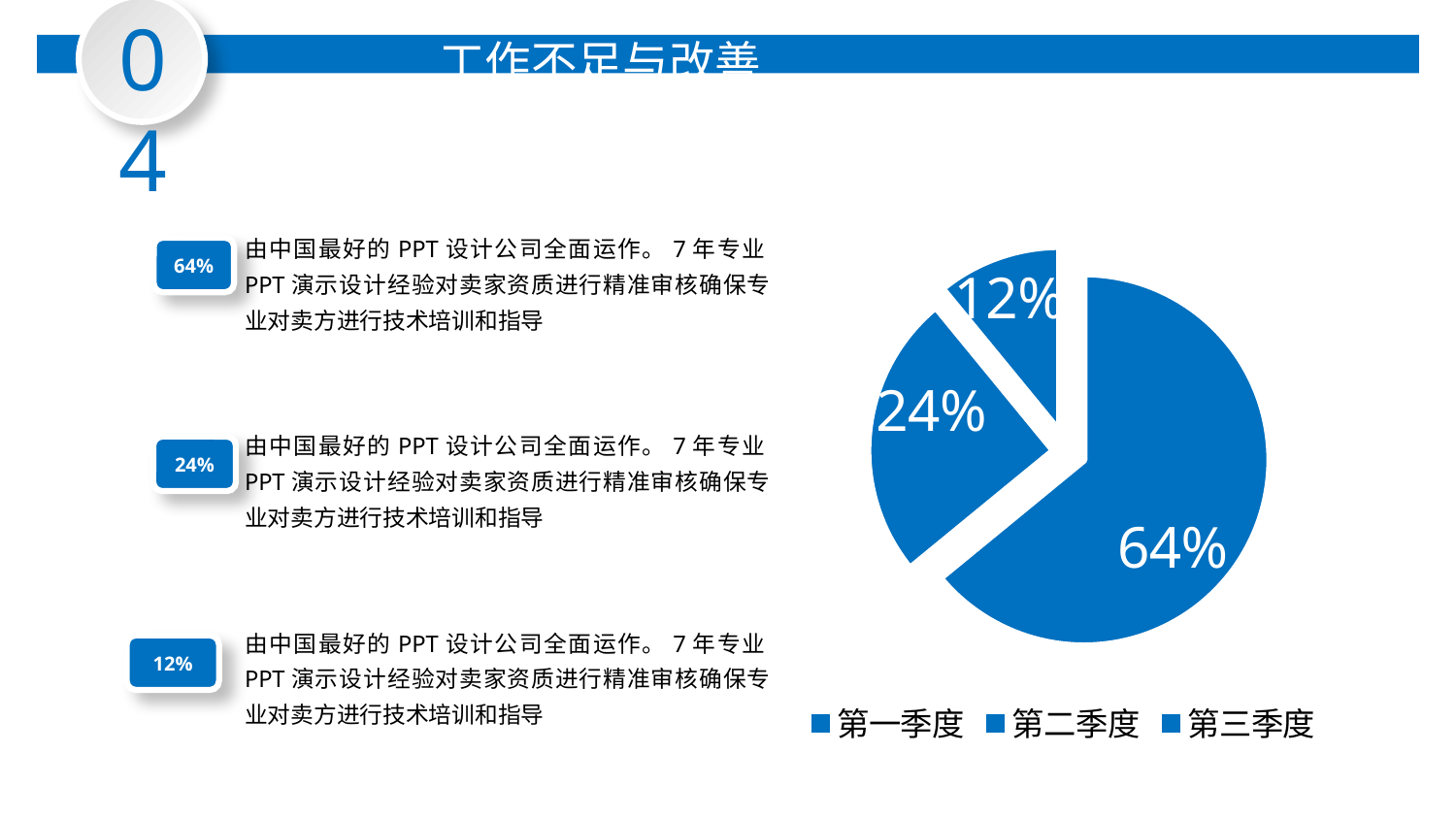
Is the largest slice of the pie chart greater or less than 50%? greater How many entries does the pie chart's legend list? 3 What kind of chart is shown on the slide? pie chart What share of the pie does the largest slice take? 64% What is the value of the smallest slice in the pie chart? 12% How many slices does the pie chart have? 3 Which is larger in the pie chart, the 24% slice or the 12% slice? the 24% slice What is the difference between the largest and smallest slices in the pie chart? 52% What are the three legend entries of the pie chart? 第一季度, 第二季度, 第三季度 What is the difference between the 64% slice and the 24% slice in the pie chart? 40% What is the total of the three slice values shown in the pie chart? 100% What is the value of the largest slice in the pie chart? 64%